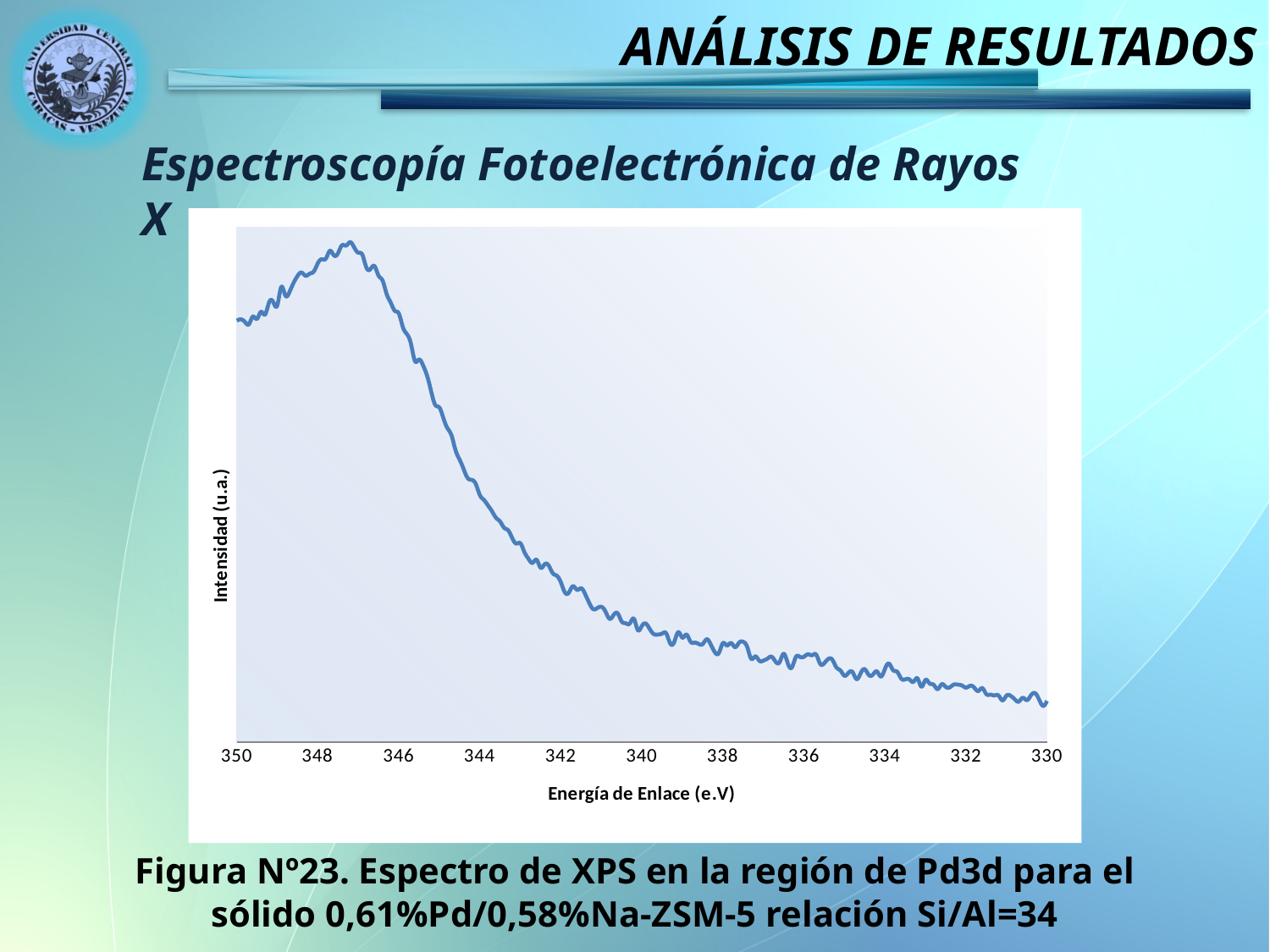
Moving from 350 to 348 on the x axis, does the intensity rise or fall? rise Is the intensity higher at 348 or at 340 on the x axis? 348 How many tick labels are shown on the x axis of the chart? 11 What is the label of the y axis of the chart? Intensidad (u.a.) Moving from 346 to 330 on the x axis, does the intensity rise or fall? fall What kind of chart is shown on the slide? line chart What is the label of the x axis of the chart? Energía de Enlace (e.V) Among the labeled x-axis ticks, at which one is the intensity lowest? 330 What is the leftmost value shown on the x axis of the chart? 350 Among the labeled x-axis ticks, at which one is the intensity highest? 348 How many lines are plotted on the chart? 1 What is the rightmost value shown on the x axis of the chart? 330